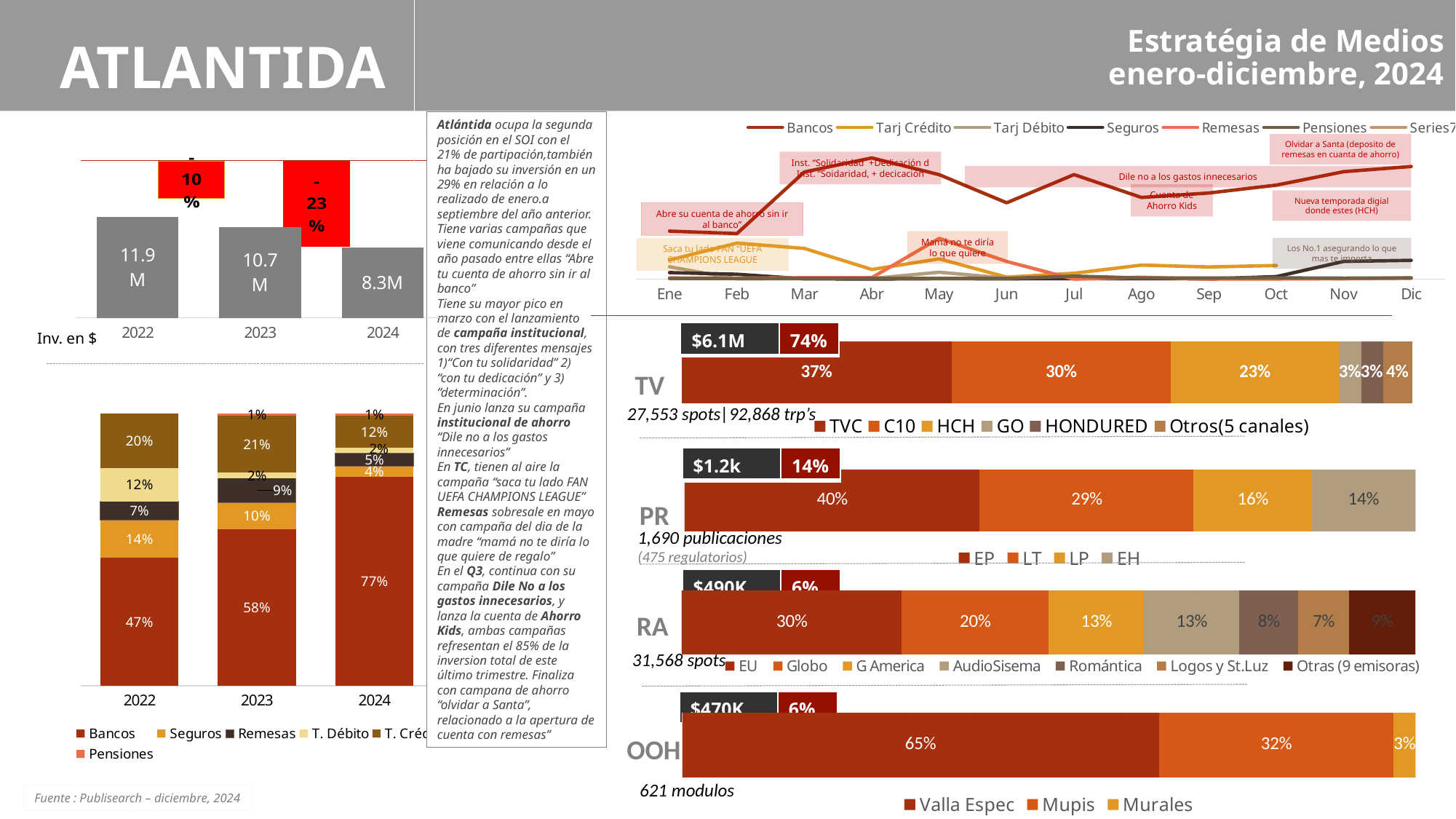
In the 'Inv. en $' bar chart on the left, do the values rise or fall from 2022 to 2024? fall In the stacked bar chart at the bottom left, how many series does the legend list? 6 In the TV bar chart on the right, what is the share for C10? 30% In the TV bar chart on the right, what is the difference between the TVC share and the HCH share? 14% In the stacked bar chart at the bottom left, what is the share for Seguros in 2022? 14% In the 'Inv. en $' bar chart on the left, which year has the lowest investment? 2024 In the 'Inv. en $' bar chart on the left, what is the value for 2022? 11.9M In the OOH bar chart on the right, what is the share for Mupis? 32% In the 'Inv. en $' bar chart on the left, how many years are shown? 3 In the RA bar chart on the right, which is larger, the share for Globo or the share for G America? Globo In the PR bar chart on the right, which outlet has the highest share? EP In the stacked bar chart at the bottom left, what is the share for Bancos in 2024? 77%